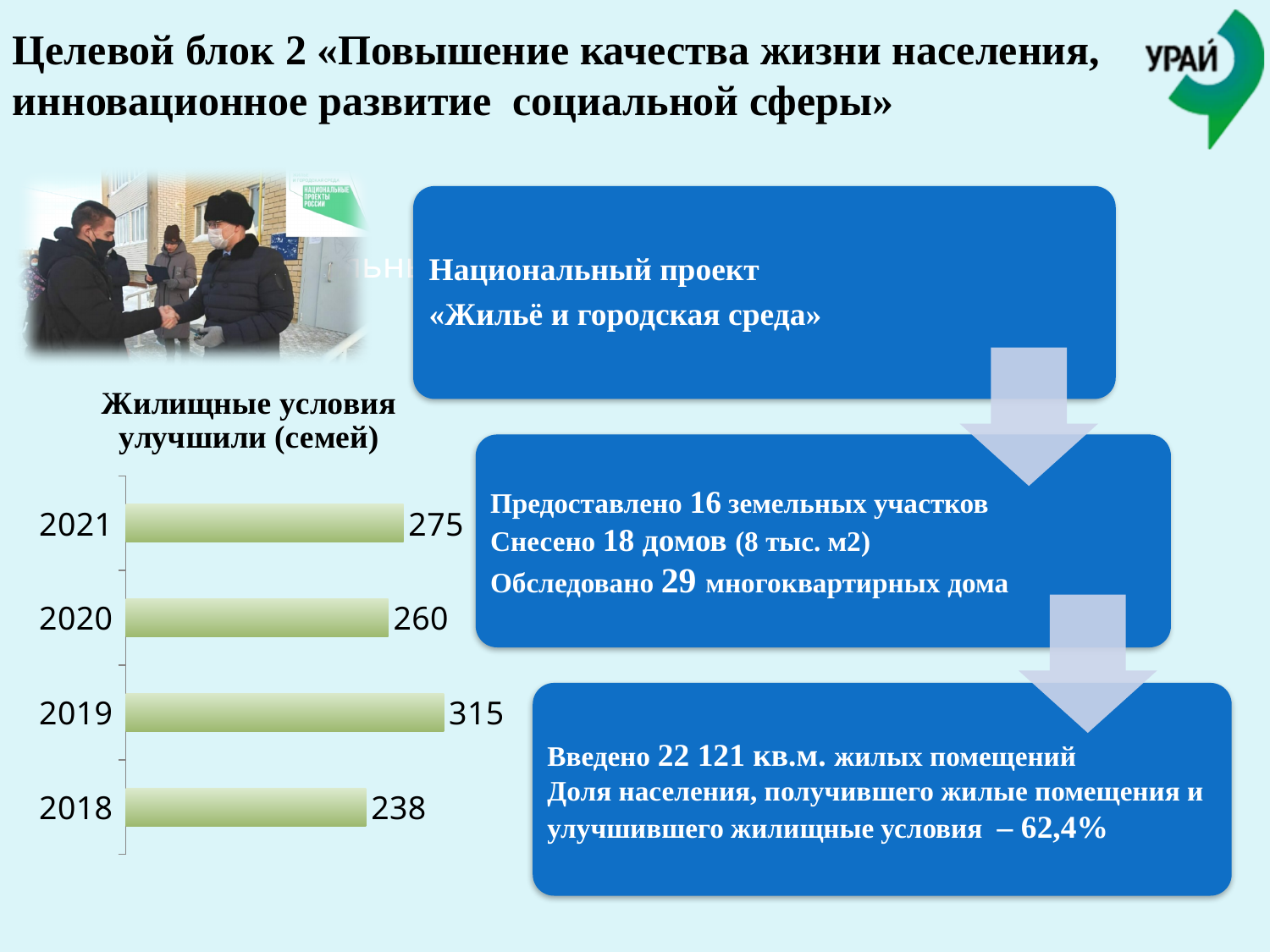
What is the difference between the values for 2021 and 2020 in the chart 'Жилищные условия улучшили (семей)'? 15 What colour are the bars in the chart 'Жилищные условия улучшили (семей)'? light green How many years are shown in the chart 'Жилищные условия улучшили (семей)'? 4 What is the difference between the values for 2019 and 2018 in the chart 'Жилищные условия улучшили (семей)'? 77 Which year has the lowest value in the chart 'Жилищные условия улучшили (семей)'? 2018 What is the title of the chart on the slide? Жилищные условия улучшили (семей) Which is larger in the chart 'Жилищные условия улучшили (семей)': the value for 2020 or the value for 2021? 2021 What kind of chart is 'Жилищные условия улучшили (семей)'? bar chart What is the value for 2020 in the chart 'Жилищные условия улучшили (семей)'? 260 What is the value for 2018 in the chart 'Жилищные условия улучшили (семей)'? 238 Which year has the highest value in the chart 'Жилищные условия улучшили (семей)'? 2019 What is the value for 2021 in the chart 'Жилищные условия улучшили (семей)'? 275